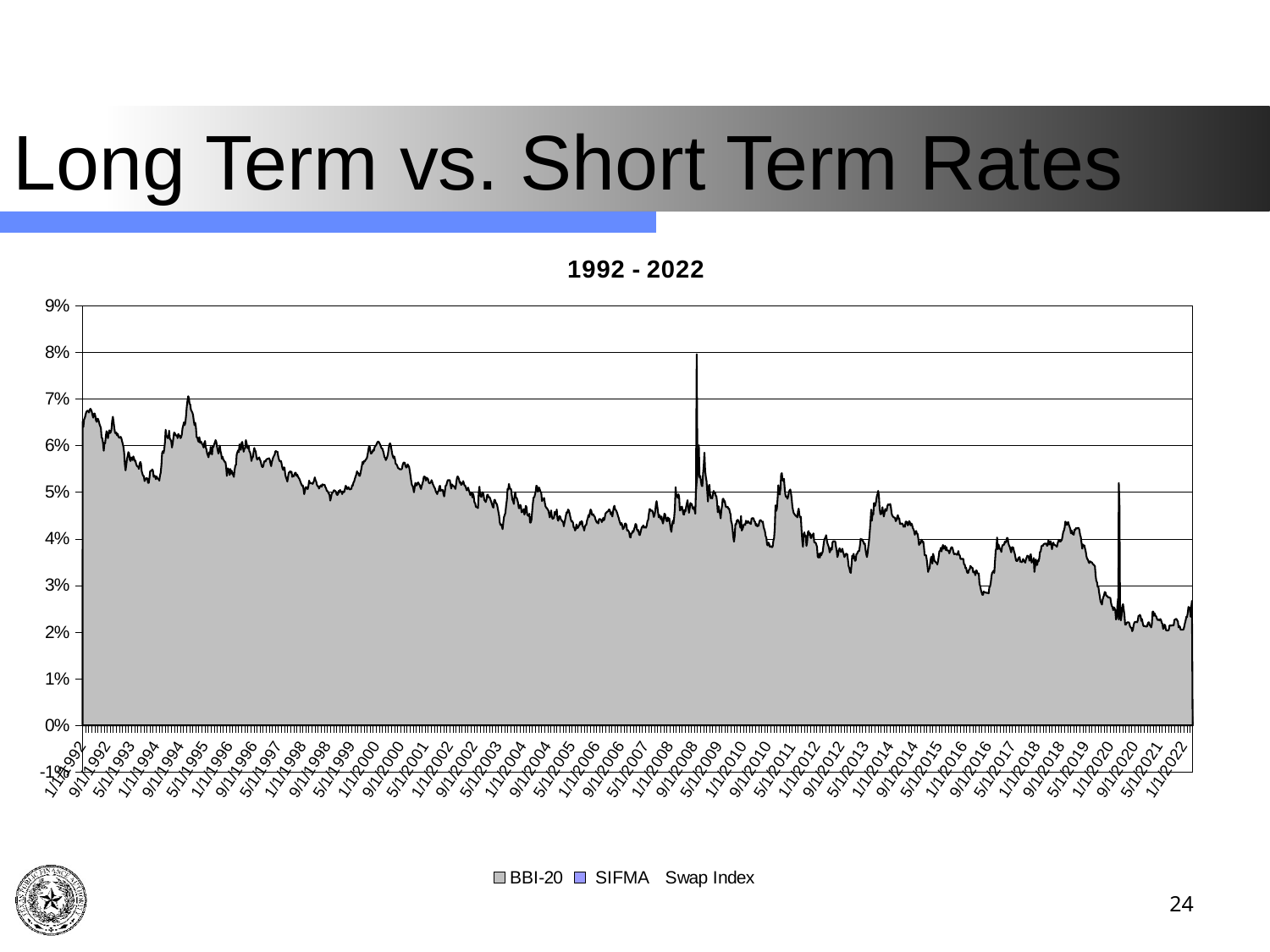
Is the BBI-20 value at 1/1/2016 greater or less than 4%? less Is the BBI-20 value at 1/1/2010 greater or less than 5%? less Which series is shown as the gray shaded area? BBI-20 What kind of chart is shown on the slide? Area chart Is the highest spike in the BBI-20 series, near the end of 2008, greater or less than 7%? greater What is the title of the chart? 1992 - 2022 How many series does the legend list? 2 Do the BBI-20 values generally rise or fall from 1992 to 2022? Fall Is the BBI-20 value at 1/1/1992 greater or less than the value at 1/1/2022? greater